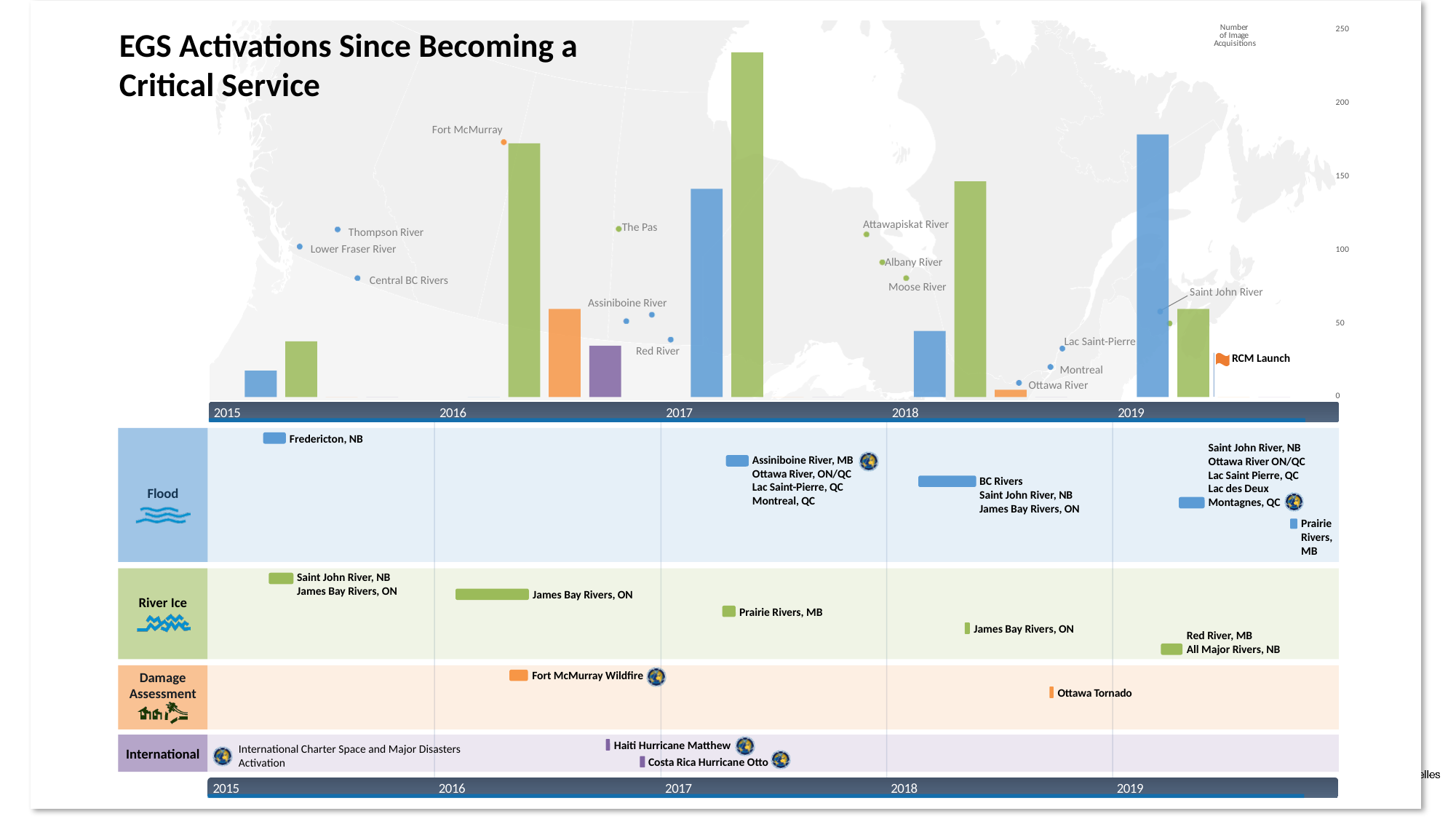
Is the value of the orange bar for 2018 greater or less than 50? less Which is larger, the blue bar for 2018 or the blue bar for 2019? 2019 How many bars are plotted for the year 2016? 3 What is the label of the vertical axis of the chart? Number of Image Acquisitions Is the value of the blue bar for 2017 greater or less than 100? greater In which year does the tallest bar in the chart appear? 2017 What kind of chart is used to show the number of image acquisitions on the slide? bar chart Is the value of the green bar for 2017 greater or less than 200? greater How many years are shown along the x axis of the bar chart? 5